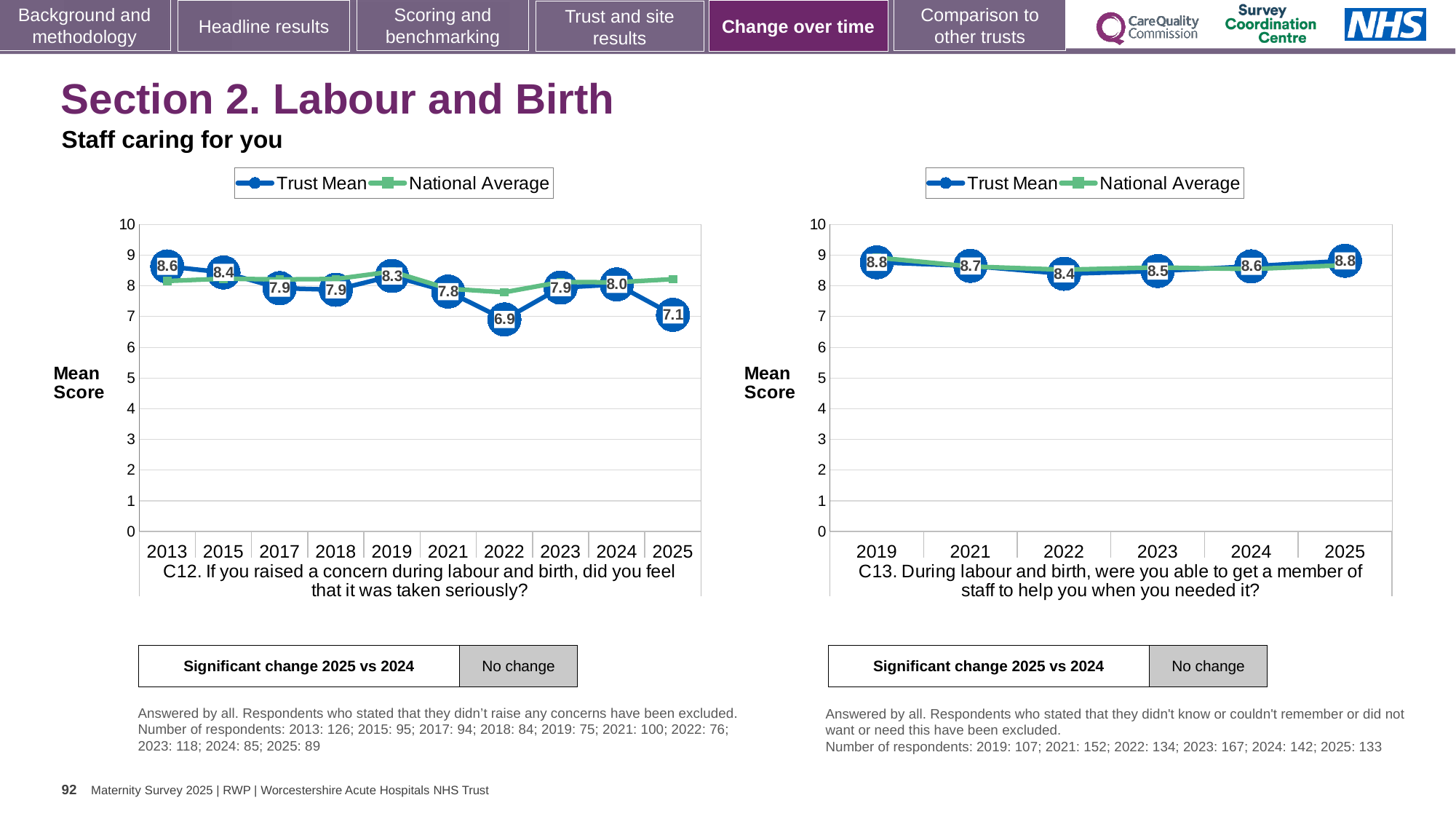
In the left chart (C12), what is the Trust Mean for 2025? 7.1 In the right chart (C13), is the National Average for 2025 greater or less than 7? greater In the left chart (C12), which year has the lowest Trust Mean? 2022 In the right chart (C13), is the Trust Mean for 2021 larger or smaller than the Trust Mean for 2023? larger In the right chart (C13), what is the Trust Mean for 2022? 8.4 What kind of chart is the left chart (C12)? Line chart How many series does the legend of the right chart (C13) list? 2 In the left chart (C12), which year has the highest Trust Mean? 2013 In the right chart (C13), which year has the lowest Trust Mean? 2022 In the left chart (C12), how many years are shown on the x axis? 10 In the left chart (C12), what is the Trust Mean for 2022? 6.9 In the left chart (C12), what is the difference between the Trust Mean for 2024 and 2025? 0.9